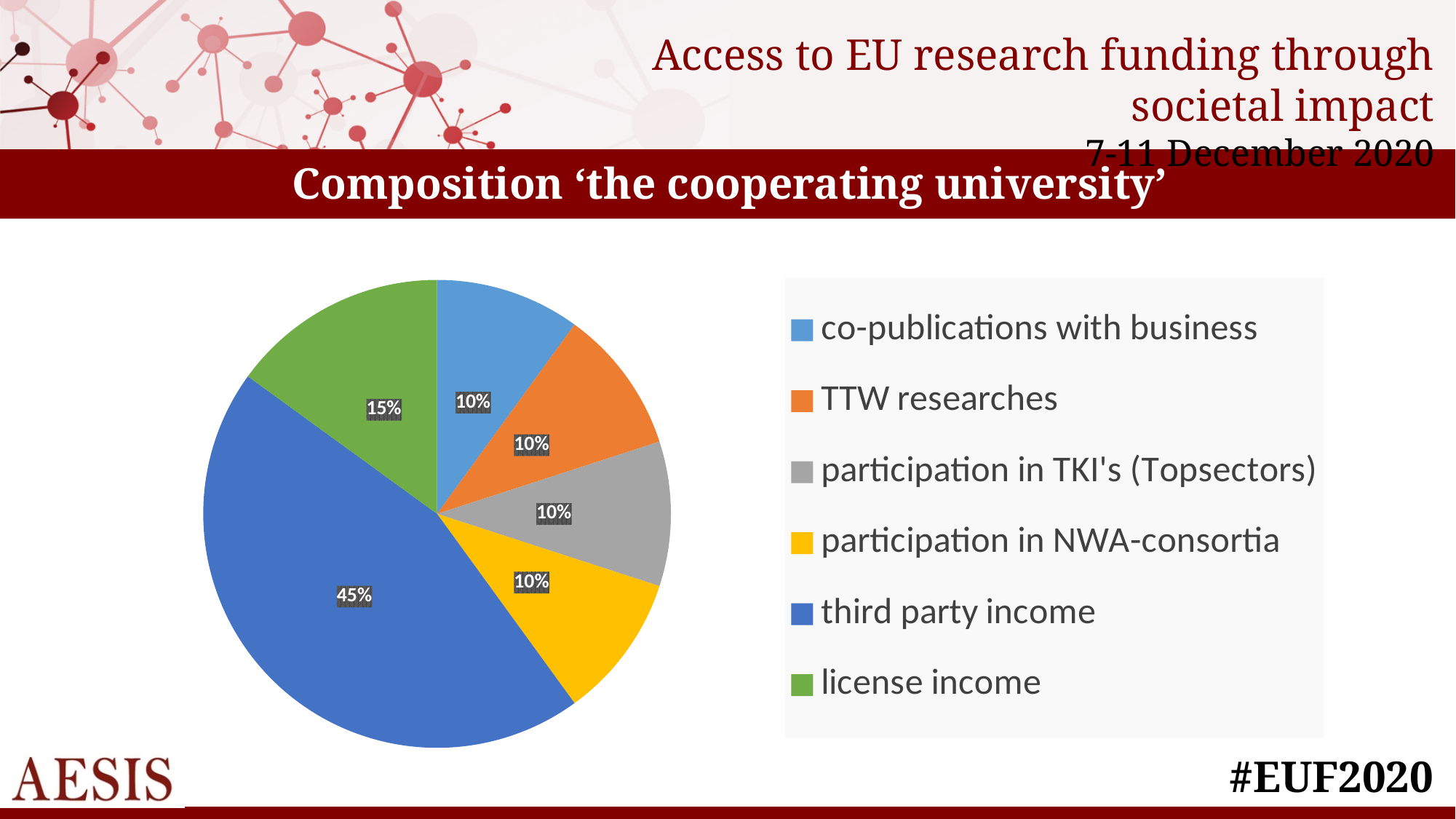
What share of the pie does license income have? 15% Which is larger, the slice for license income or the slice for TTW researches? license income What kind of chart is shown on the slide? pie chart How many slices share the value 10%? 4 How many categories does the legend list? 6 What share of the pie does third party income have? 45% What share of the pie does participation in NWA-consortia have? 10% What share of the pie do co-publications with business have? 10% Which category has the largest slice of the pie? third party income Which colour represents participation in TKI's (Topsectors) in the legend? grey What is the difference in percentage points between third party income and license income? 30 What is the title of the chart? Composition 'the cooperating university'